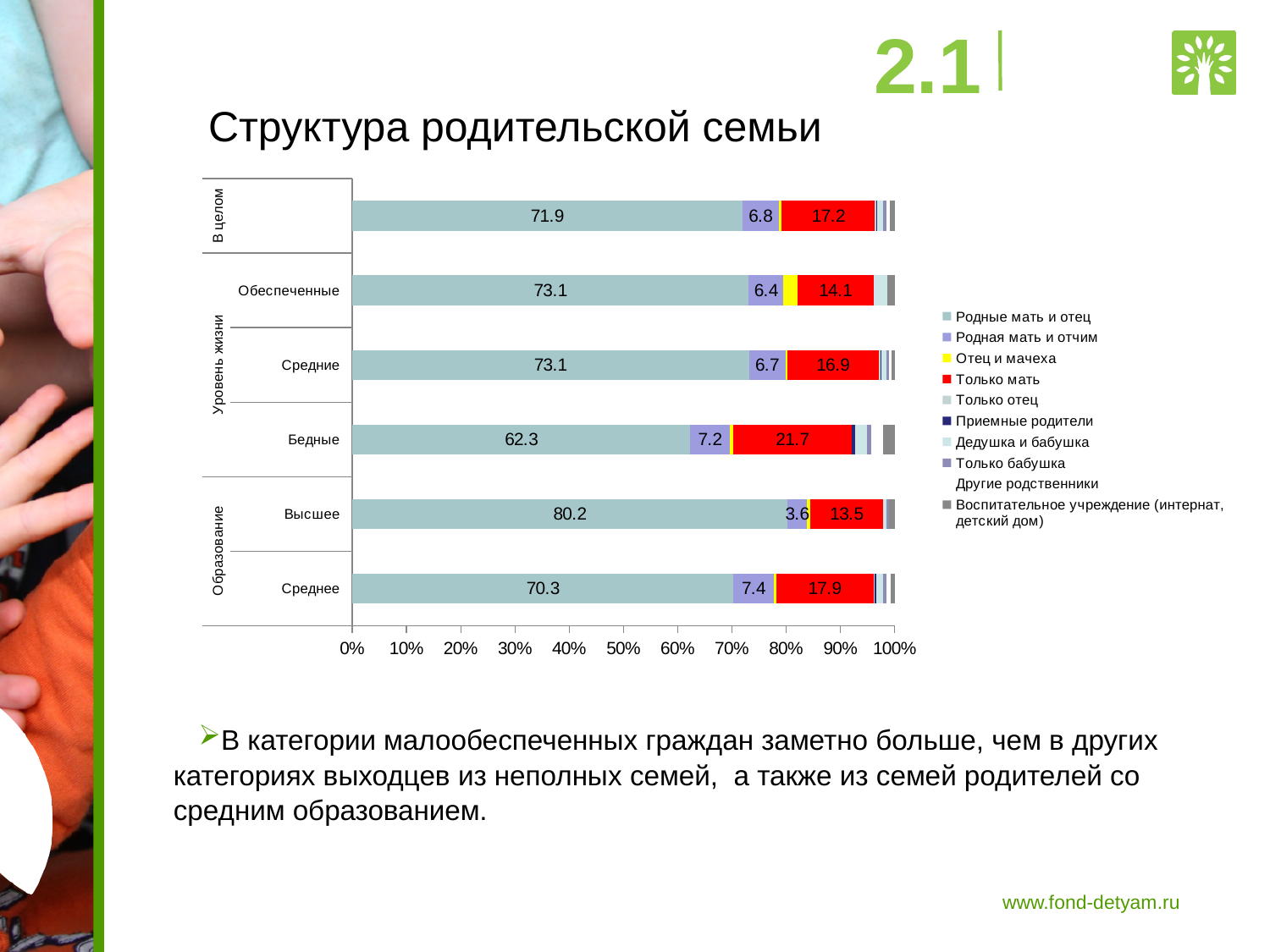
What is the value for "Родные мать и отец" in the "Бедные" category? 62.3 What is the value for "Только мать" in the "Высшее" category? 13.5 Which category has the lowest value for "Родная мать и отчим"? Высшее How many categories (bars) are shown in the chart? 6 Which category has the highest value for "Только мать"? Бедные What colour represents "Только мать" in the chart? Red Which is larger: the "Родные мать и отец" value for "Среднее" or for "Средние"? Средние What is the value for "Родная мать и отчим" in the "В целом" category? 6.8 Which category has the highest value for "Родные мать и отец"? Высшее What kind of chart is shown on the slide? Stacked bar chart What is the difference between the "Только мать" values for "Бедные" and "Обеспеченные"? 7.6 How many series does the legend list? 10